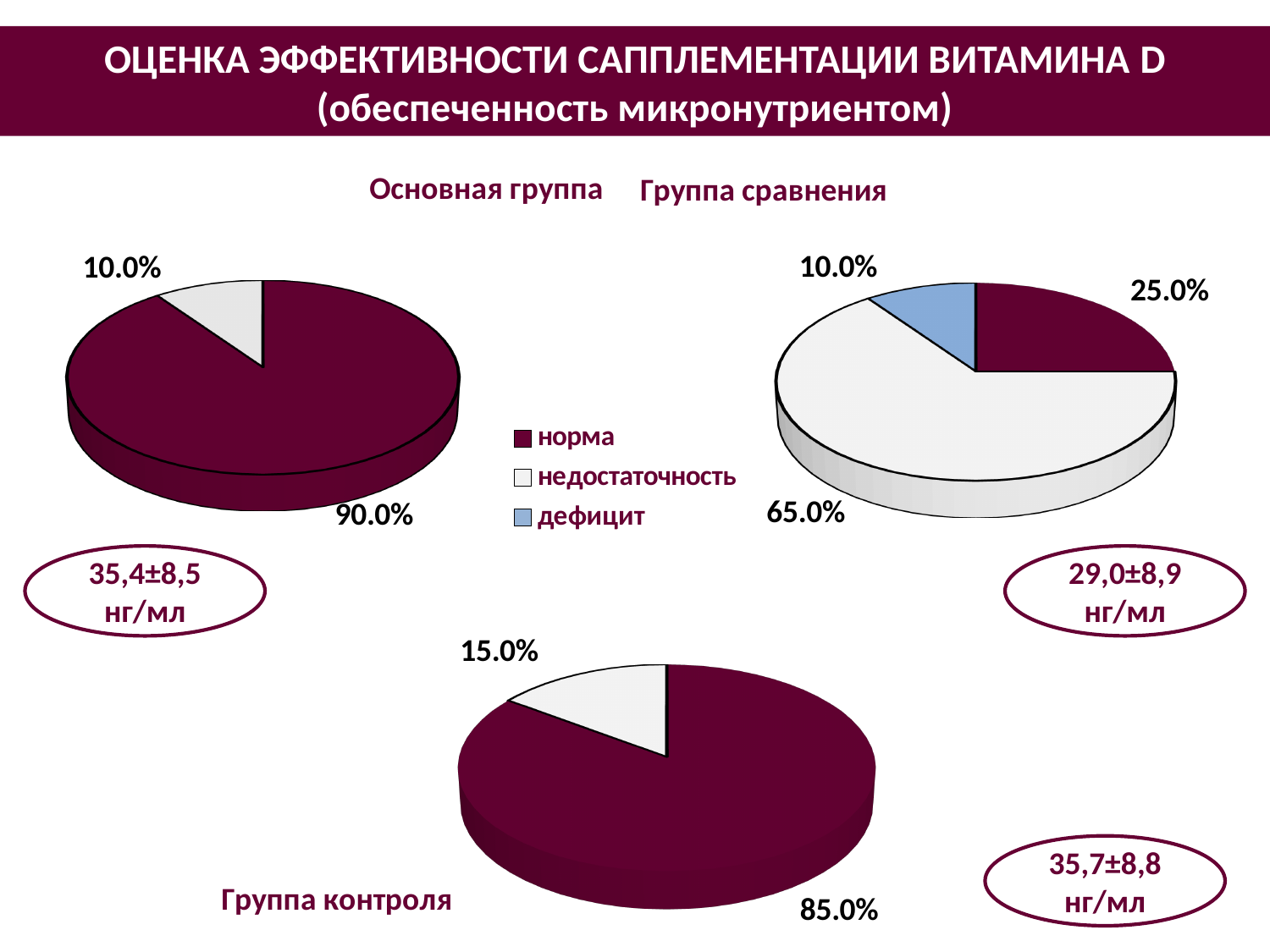
In the "Основная группа" chart, what share is labelled for the "норма" slice? 90.0% Which is larger: the "норма" share in the "Основная группа" chart or the "норма" share in the "Группа сравнения" chart? Основная группа In the "Группа сравнения" chart, which category has the largest slice? недостаточность In the "Группа сравнения" chart, what share is labelled for the "недостаточность" slice? 65.0% What kind of charts are shown on the slide? Pie charts In the "Группа сравнения" chart, what share is labelled for the "норма" slice? 25.0% In the "Группа контроля" chart, which category has the smallest slice? недостаточность How many categories does the legend list? 3 What is the difference between the "норма" share in the "Основная группа" chart and the "норма" share in the "Группа контроля" chart? 5.0%